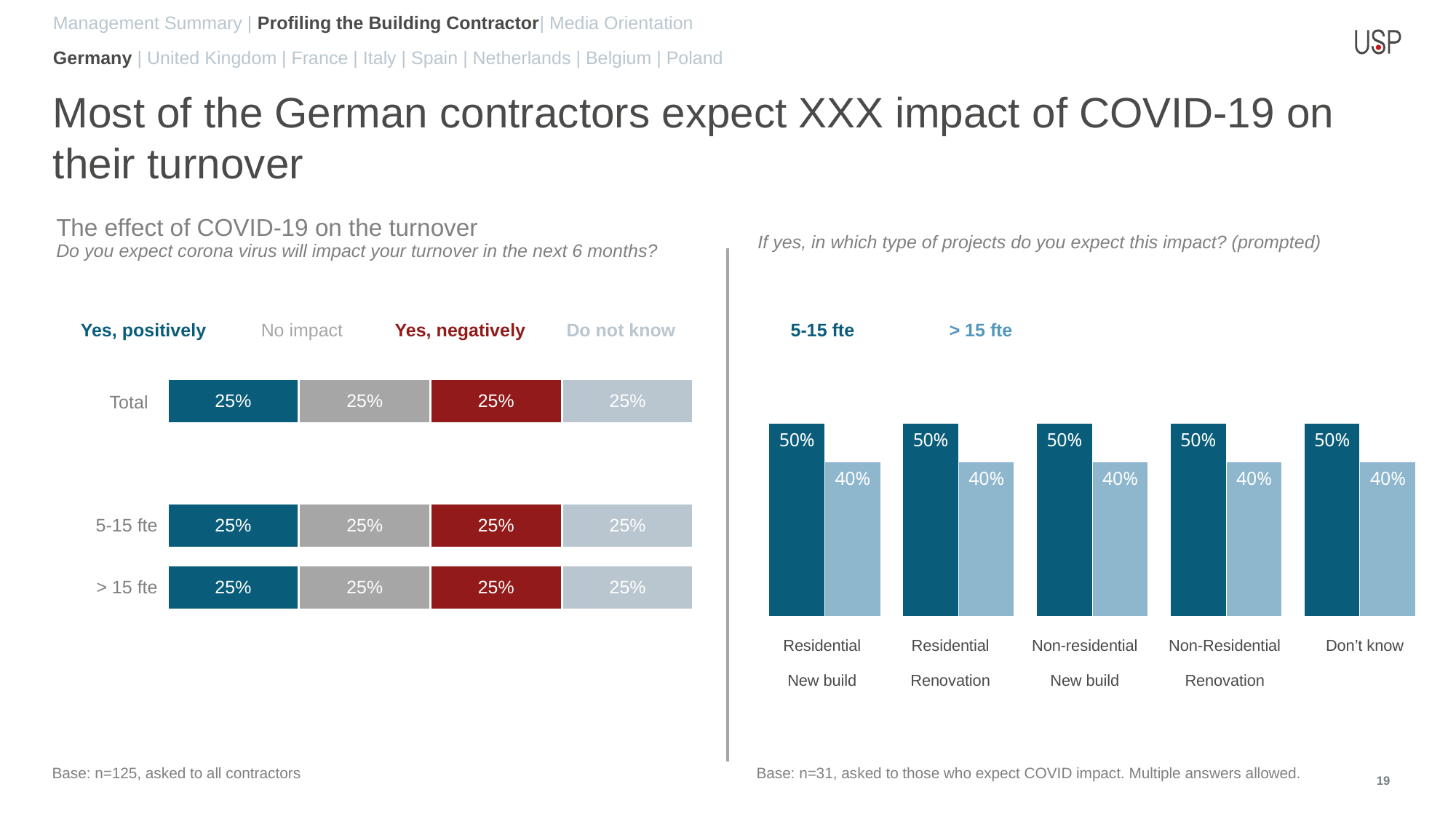
In the left chart, 'The effect of COVID-19 on the turnover', what is the 'Do not know' value for the > 15 fte row? 25% In the right chart, 'If yes, in which type of projects do you expect this impact?', what is the value for > 15 fte for Non-residential New build? 40% In the left chart, 'The effect of COVID-19 on the turnover', what percentage of the Total row answered 'Yes, negatively'? 25% In the right chart, 'If yes, in which type of projects do you expect this impact?', how many series does the legend list? 2 In the right chart, 'If yes, in which type of projects do you expect this impact?', what is the value for 5-15 fte for Residential Renovation? 50% In the right chart, 'If yes, in which type of projects do you expect this impact?', how many project categories are shown on the x axis? 5 In the right chart, 'If yes, in which type of projects do you expect this impact?', which is larger for Residential New build: 5-15 fte or > 15 fte? 5-15 fte In the left chart, 'The effect of COVID-19 on the turnover', what is the total of the stacked bar for the 5-15 fte row? 100% In the right chart, 'If yes, in which type of projects do you expect this impact?', what is the difference between the 5-15 fte and > 15 fte values for Don't know? 10% In the left chart, 'The effect of COVID-19 on the turnover', how many series does the legend list? 4 In the left chart, 'The effect of COVID-19 on the turnover', how many rows (categories) are plotted? 3 What kind of chart is the left chart, 'The effect of COVID-19 on the turnover'? Stacked bar chart